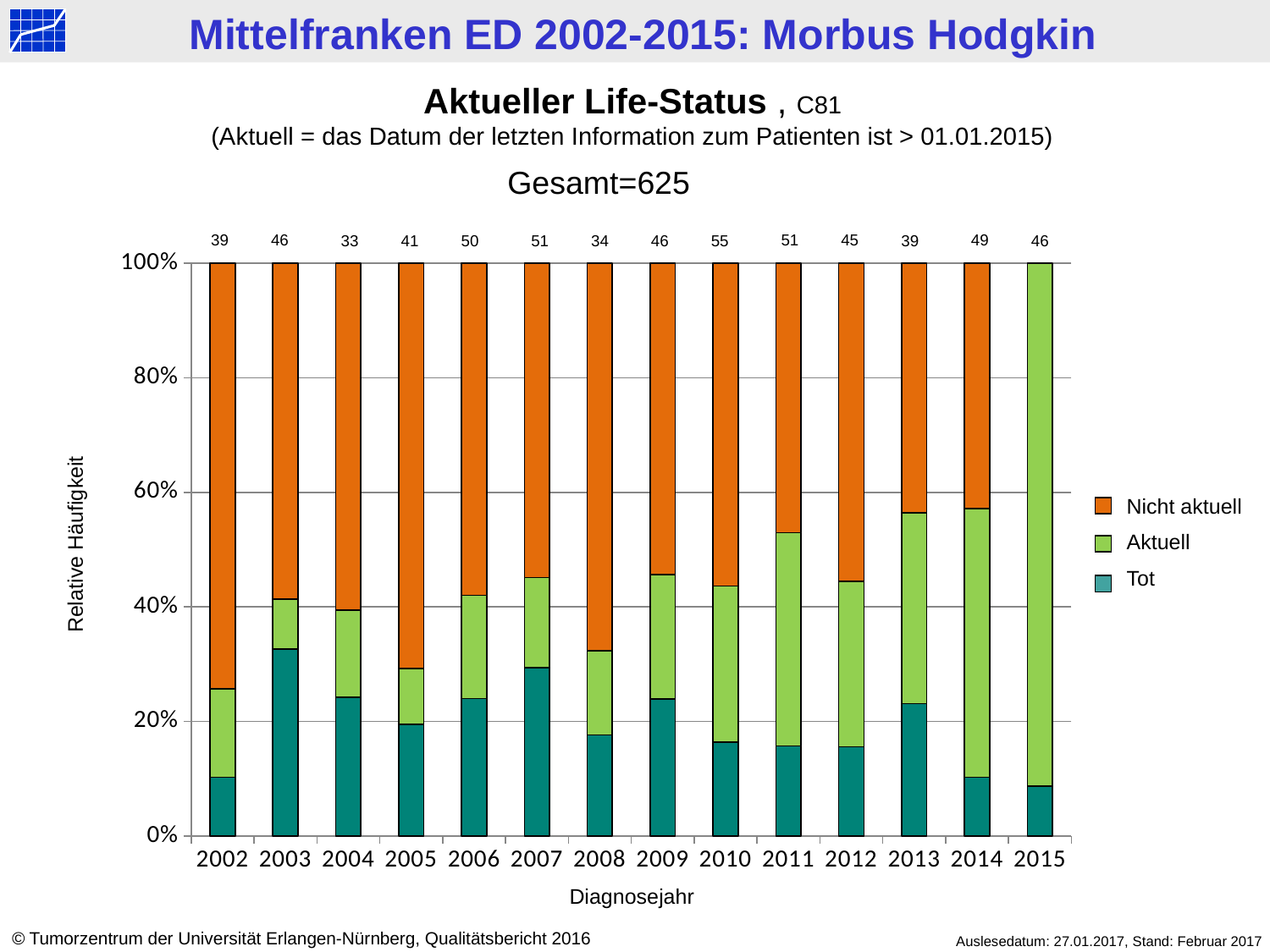
What kind of chart is shown on the slide? bar chart What is the number of patients printed above the bar for 2004? 33 What total number of patients (Gesamt) is stated on the slide? 625 What is the number of patients printed above the bar for 2010? 55 What is the difference between the patient counts printed above the bars for 2010 and 2004? 22 Is the share of 'Tot' for 2015 greater or less than 20%? less How many series does the legend list? 3 Is the share of 'Tot' for 2003 greater or less than 20%? greater Which diagnosis year has the highest number of patients printed above its bar? 2010 Which year has a larger patient count printed above its bar, 2006 or 2013? 2006 How many diagnosis years (categories) are shown on the x axis? 14 Which diagnosis year has the lowest number of patients printed above its bar? 2004